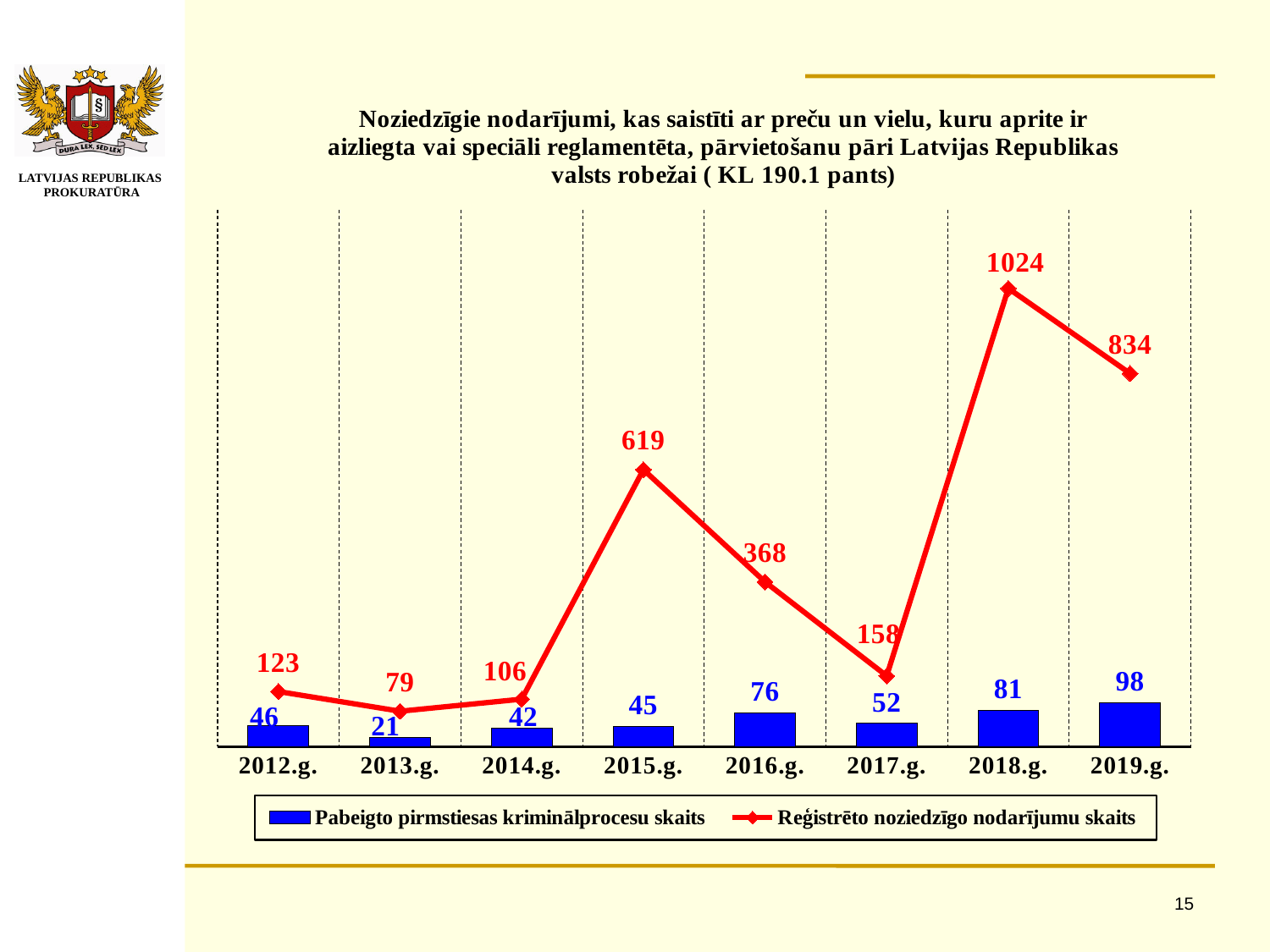
Which is larger: Reģistrēto noziedzīgo nodarījumu skaits in 2016.g. or in 2017.g.? 2016.g. Which year has the highest value for Reģistrēto noziedzīgo nodarījumu skaits? 2018.g. What kind of chart is shown on the slide? Combined bar and line chart What is the difference between the Pabeigto pirmstiesas kriminālprocesu skaits values for 2019.g. and 2018.g.? 17 How many years are shown on the x axis? 8 What is the value of Reģistrēto noziedzīgo nodarījumu skaits for 2015.g.? 619 What is the value of Reģistrēto noziedzīgo nodarījumu skaits for 2018.g.? 1024 Which year has the lowest value for Pabeigto pirmstiesas kriminālprocesu skaits? 2013.g. What is the value of Pabeigto pirmstiesas kriminālprocesu skaits for 2013.g.? 21 What is the difference between the Reģistrēto noziedzīgo nodarījumu skaits values for 2018.g. and 2019.g.? 190 How many series does the legend list? 2 Which year has the lowest value for Reģistrēto noziedzīgo nodarījumu skaits? 2013.g.